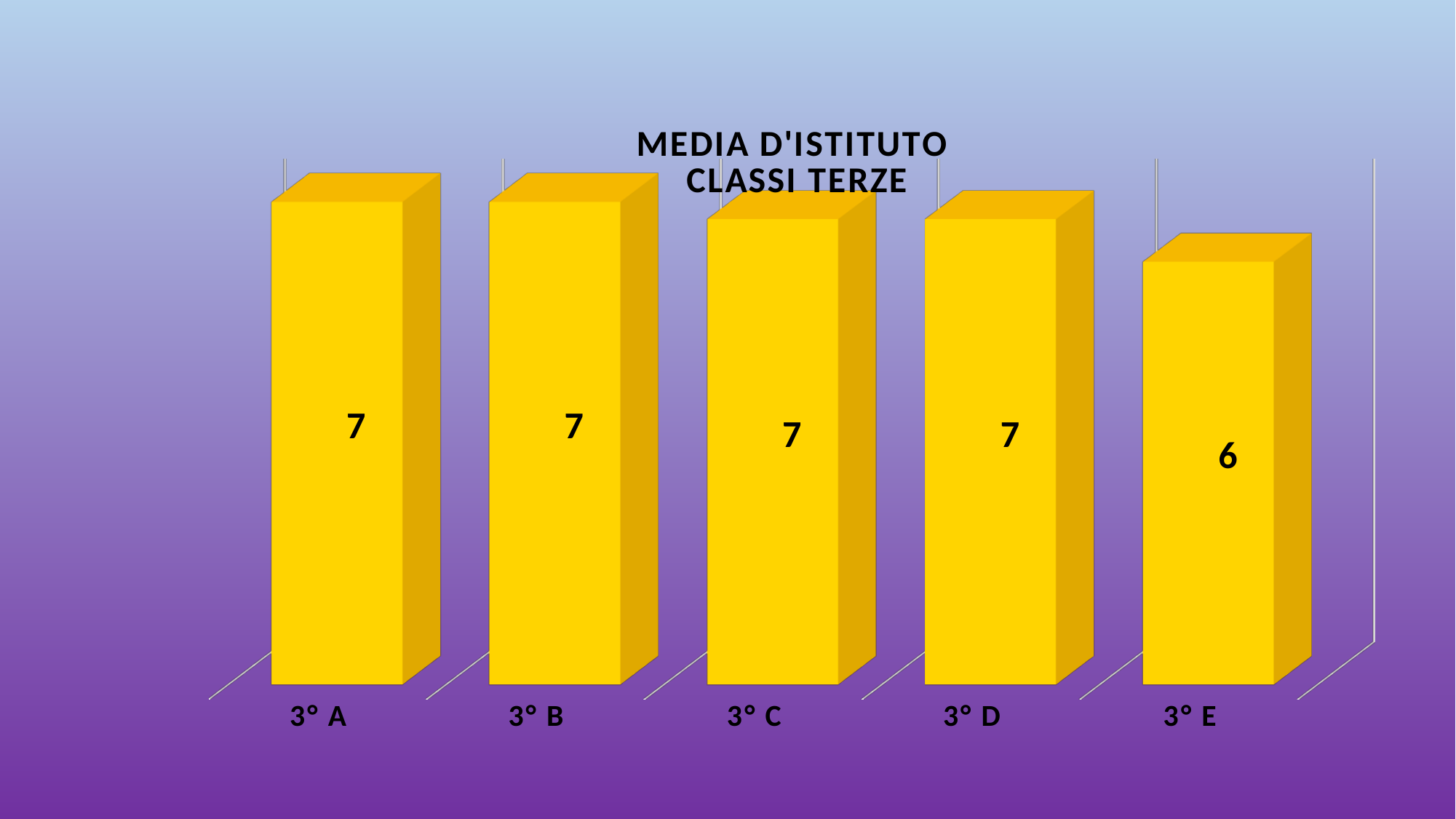
What is the value for 3° C? 7 What is the title of the chart? MEDIA D'ISTITUTO CLASSI TERZE How many classes are shown in the chart? 5 Do the values rise or fall from 3° A to 3° E? fall Which is larger, the value for 3° A or the value for 3° E? 3° A What colour are the bars in the chart? yellow What is the value for 3° A? 7 Which class has the lowest value? 3° E What kind of chart is shown on the slide? bar chart What is the value for 3° D? 7 What is the difference between the values for 3° B and 3° E? 1 What is the value for 3° E? 6